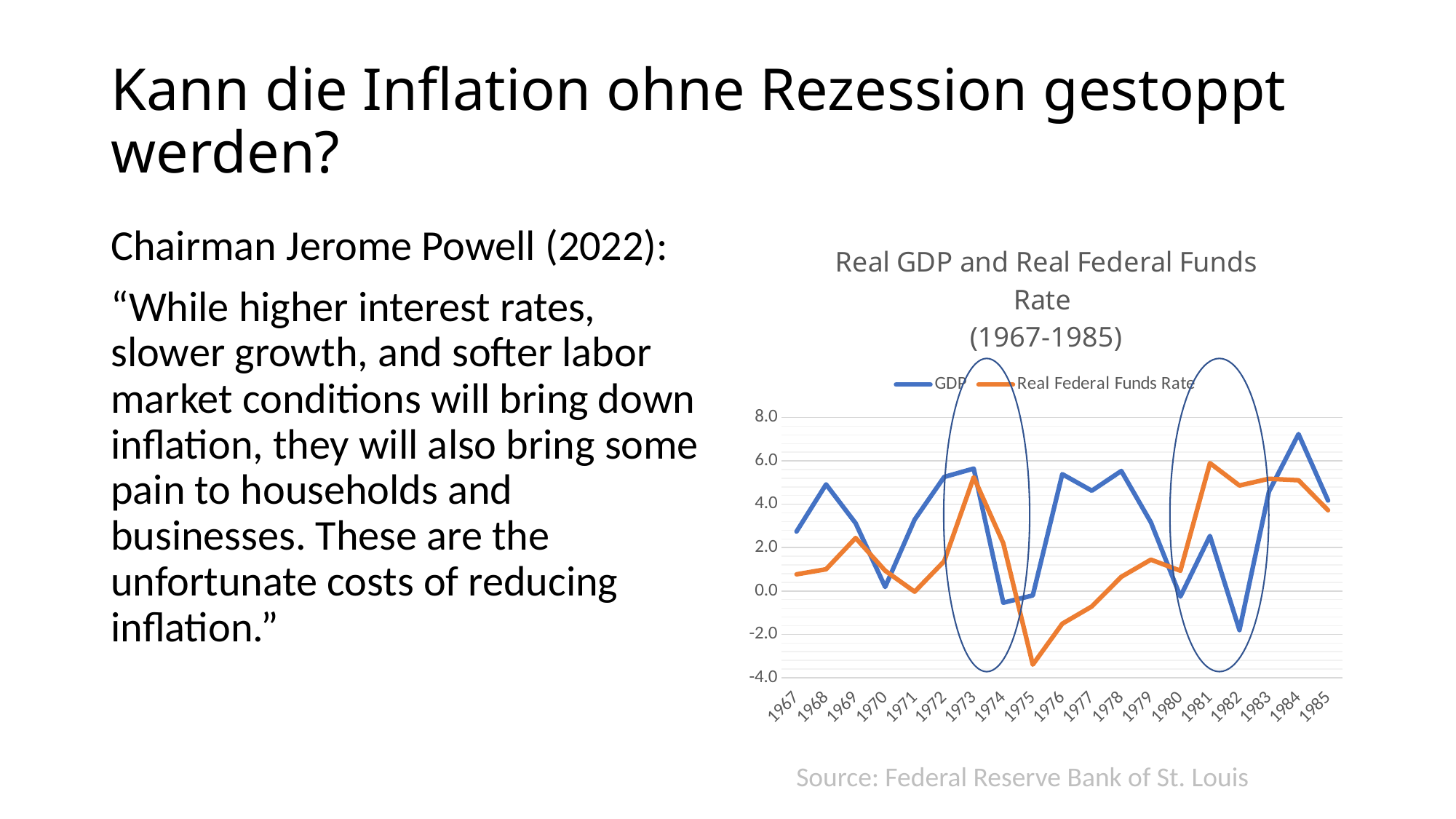
In which year is the Real Federal Funds Rate lowest in the chart? 1975 Is the GDP value for 1982 greater or less than 0.0? less Is the GDP value for 1984 greater or less than 6.0? greater What kind of chart is shown on the slide? line chart In 1981, which is larger: GDP or the Real Federal Funds Rate? Real Federal Funds Rate How many series does the legend of the chart list? 2 Is the Real Federal Funds Rate value for 1975 greater or less than -2.0? less Does GDP rise or fall from 1982 to 1984? rise In which year is GDP lowest in the chart? 1982 What is the source given below the chart? Federal Reserve Bank of St. Louis How many years are shown on the x axis of the chart? 19 In which year is GDP highest in the chart? 1984